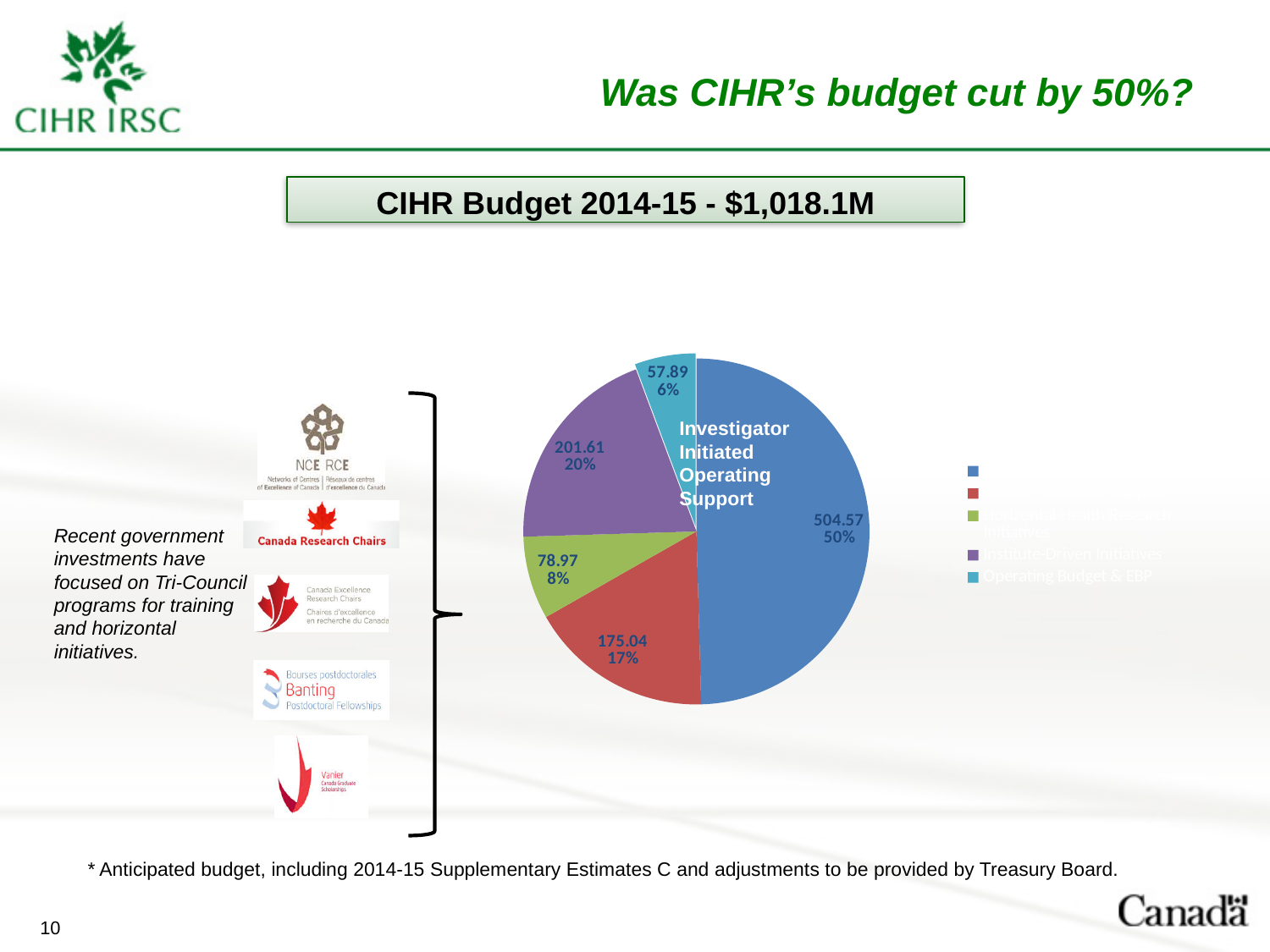
What value is shown on the green slice of the pie chart? 78.97 What kind of chart is shown on the slide? pie chart What is the difference between the purple slice (201.61) and the red slice (175.04)? 26.57 Which slice of the pie chart is the largest? Investigator Initiated Operating Support How many slices does the pie chart have? 5 What is the difference between the Investigator Initiated Operating Support slice (504.57) and the purple slice (201.61)? 302.96 What is the value shown for the Investigator Initiated Operating Support slice? 504.57 What share of the pie does the Investigator Initiated Operating Support slice represent? 50% What is the value of the smallest slice in the pie chart? 57.89 Which is larger, the red slice or the purple slice? the purple slice What is the title shown above the pie chart? CIHR Budget 2014-15 - $1,018.1M What percentage is shown on the red slice of the pie chart? 17%